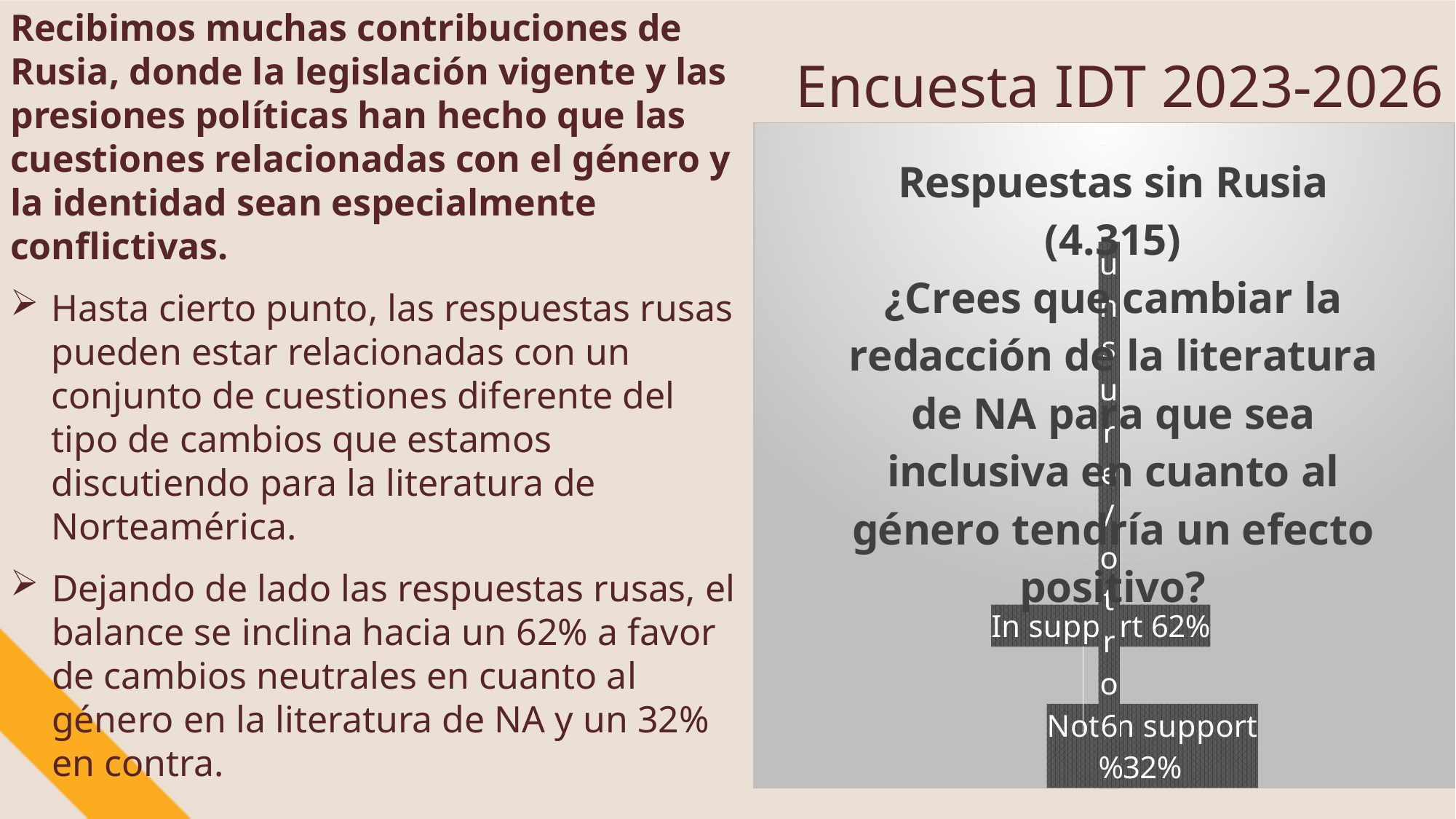
According to the chart title, how many responses were counted without Russia? 4.315 Which response category has the highest share in the chart? In support What percentage of responses are labelled "In support" in the chart? 62% Which is larger in the chart, "In support" or "Not in support"? In support By how many percentage points does "In support" exceed "Not in support" in the chart? 30 percentage points How many response categories are shown in the chart? 3 What percentage of responses are labelled "Not in support" in the chart? 32%